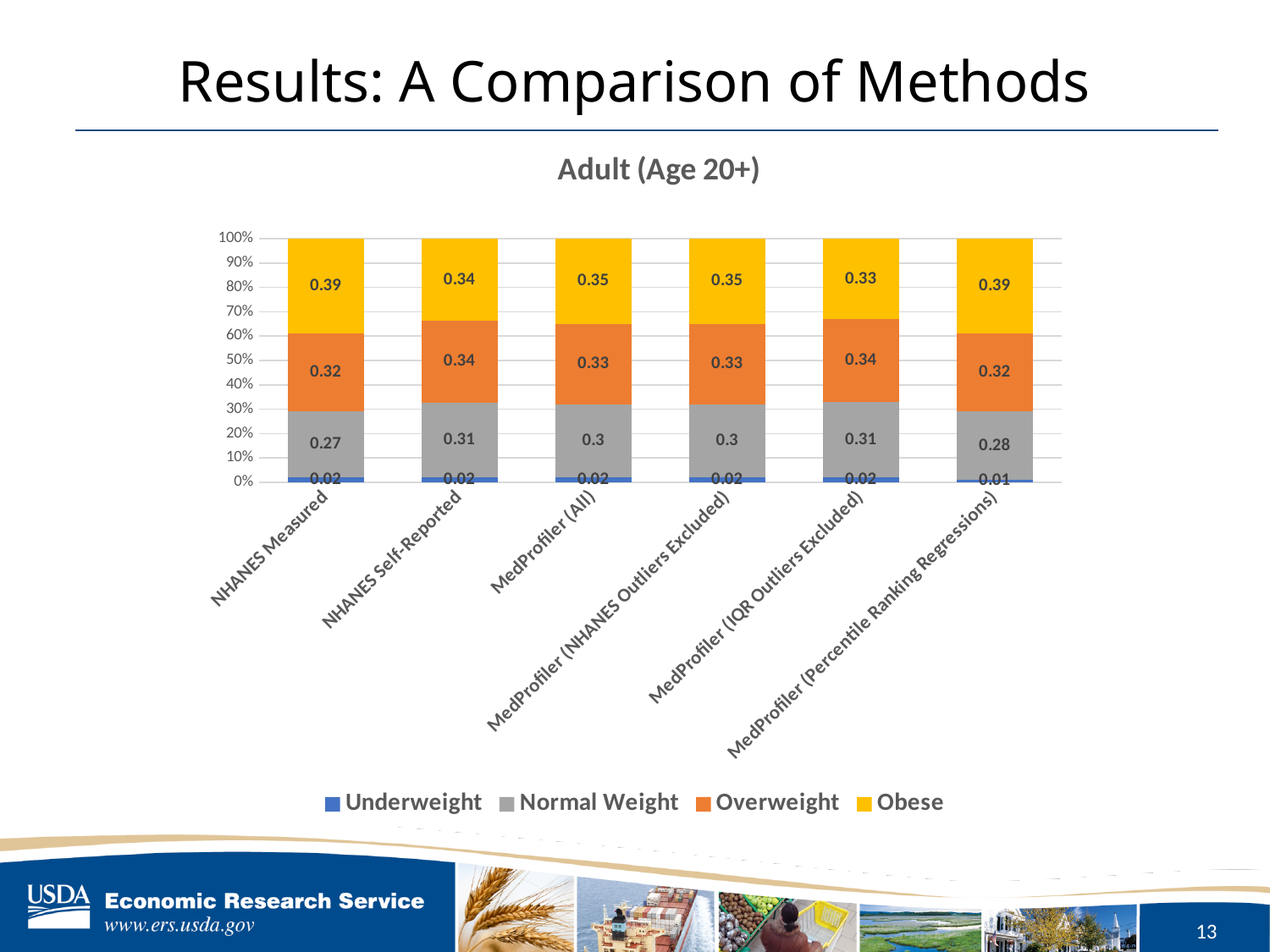
What is the Normal Weight value for NHANES Self-Reported? 0.31 How many series does the legend list? 4 Which is larger, the Normal Weight value for MedProfiler (All) or for MedProfiler (Percentile Ranking Regressions)? MedProfiler (All) Which category has the lowest Obese value? MedProfiler (IQR Outliers Excluded) What is the difference between the Obese values for NHANES Measured and NHANES Self-Reported? 0.05 What is the Underweight value for MedProfiler (Percentile Ranking Regressions)? 0.01 What is the Overweight value for MedProfiler (IQR Outliers Excluded)? 0.34 What is the title of the chart? Adult (Age 20+) What is the Obese share for NHANES Measured? 0.39 How many categories are shown on the x axis? 6 What kind of chart is shown on the slide? Stacked bar chart Which category has the lowest Normal Weight value? NHANES Measured